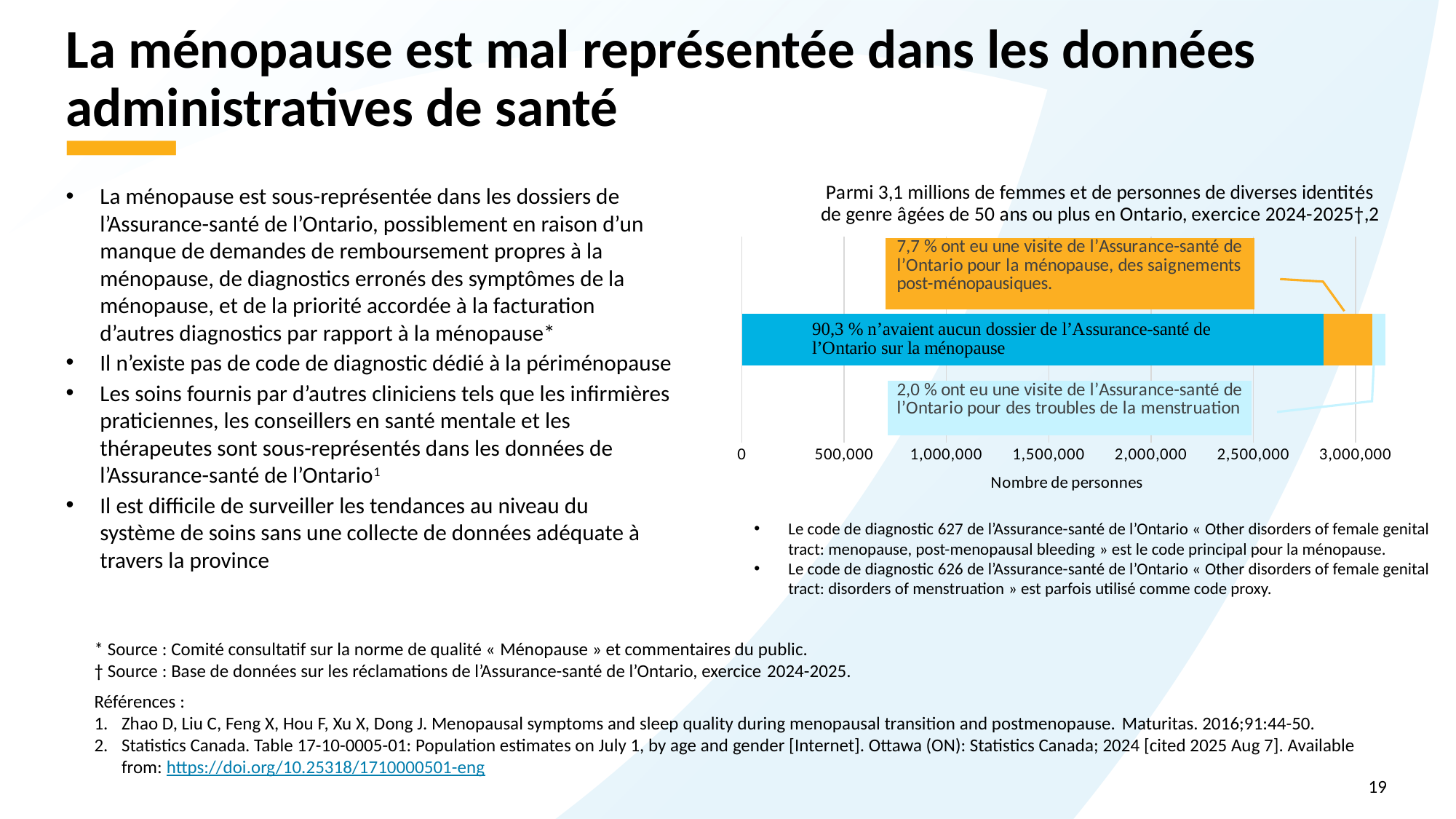
Which is larger: the share with a visit for menopause/post-menopausal bleeding or the share with a visit for disorders of menstruation? Visit for menopause/post-menopausal bleeding (7,7 %) Which group makes up the smallest segment of the bar? 2,0 % ont eu une visite pour des troubles de la menstruation What percentage had an Ontario health insurance visit for menopause or post-menopausal bleeding? 7,7 % What colour is the segment representing the 7,7 % who had a visit for menopause or post-menopausal bleeding? Orange Which group makes up the largest segment of the bar? 90,3 % n'avaient aucun dossier de l'Assurance-santé de l'Ontario sur la ménopause What is the difference in percentage points between the share with no menopause record (90,3 %) and the share with a menopause visit (7,7 %)? 82,6 What is the label of the horizontal axis? Nombre de personnes What percentage of the population had no Ontario health insurance record on menopause? 90,3 % What percentage had an Ontario health insurance visit for disorders of menstruation? 2,0 % Is the number of people with no Ontario health insurance record on menopause greater or less than 2,500,000? greater How many segments does the stacked bar contain? 3 What kind of chart is shown on the slide? Bar chart